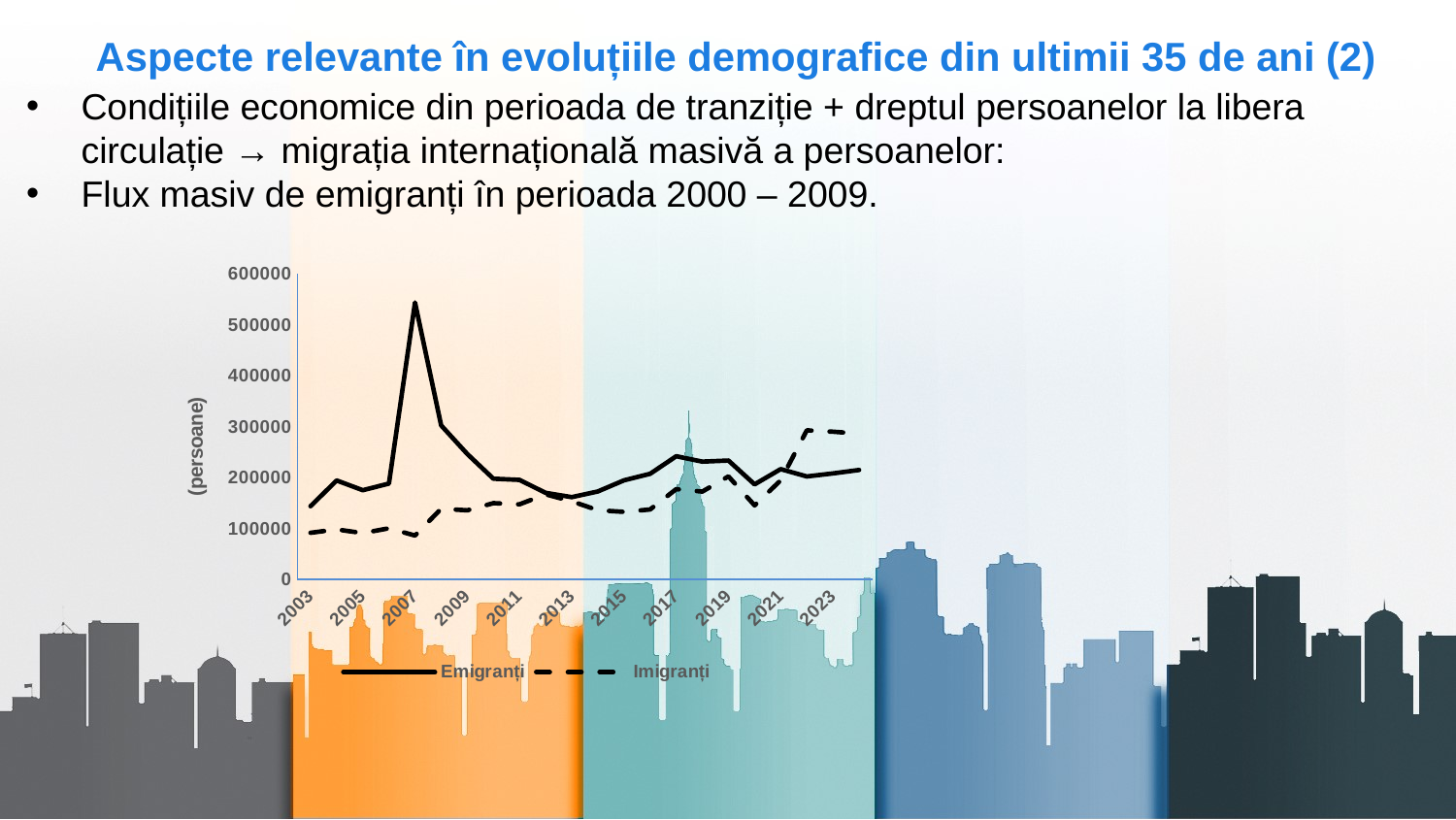
In 2007, which series has the larger value, Emigranți or Imigranți? Emigranți Is the value for Imigranți in 2023 greater or less than 200000? greater What type of chart is shown on the slide? line chart Is the value for Emigranți in 2003 greater or less than 100000? greater In 2023, which series has the larger value, Emigranți or Imigranți? Imigranți What is the label on the vertical axis of the chart? (persoane) How many series does the chart legend list? 2 Is the value for Emigranți in 2007 greater or less than 500000? greater Does the Emigranți series rise or fall between 2007 and 2009? fall In which year does the Emigranți series reach its highest value? 2007 What are the two series named in the chart legend? Emigranți and Imigranți